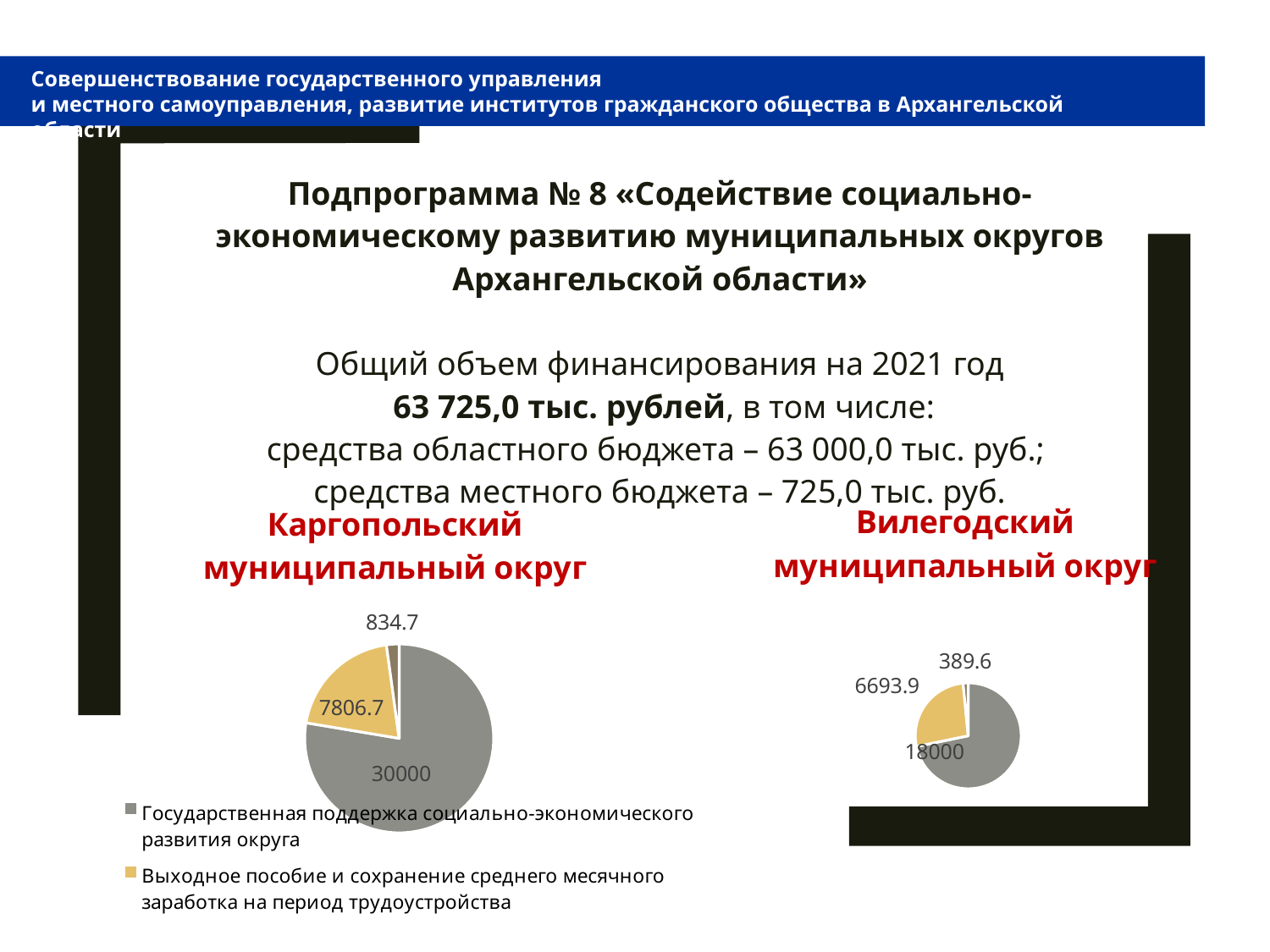
In the Каргопольский муниципальный округ chart, what is the value for Государственная поддержка социально-экономического развития округа? 30000 How many entries does the legend below the Каргопольский муниципальный округ chart list? 2 How many slices does the Каргопольский муниципальный округ pie chart have? 3 In the Каргопольский муниципальный округ chart, what is the value for Выходное пособие и сохранение среднего месячного заработка на период трудоустройства? 7806.7 Which chart shows a larger value for Государственная поддержка социально-экономического развития округа, Каргопольский муниципальный округ or Вилегодский муниципальный округ? Каргопольский муниципальный округ In the Каргопольский муниципальный округ chart, what is the difference between the value for Государственная поддержка социально-экономического развития округа and the value for Выходное пособие и сохранение среднего месячного заработка на период трудоустройства? 22193.3 In the Вилегодский муниципальный округ chart, what is the difference between the value for Государственная поддержка социально-экономического развития округа and the value for Выходное пособие и сохранение среднего месячного заработка на период трудоустройства? 11306.1 In the Вилегодский муниципальный округ chart, what is the smallest value shown? 389.6 In the Вилегодский муниципальный округ chart, what is the value for Государственная поддержка социально-экономического развития округа? 18000 What kind of chart is used for the Каргопольский муниципальный округ data? pie chart In the Вилегодский муниципальный округ chart, what is the value for Выходное пособие и сохранение среднего месячного заработка на период трудоустройства? 6693.9 In the Каргопольский муниципальный округ chart, which category has the largest slice? Государственная поддержка социально-экономического развития округа